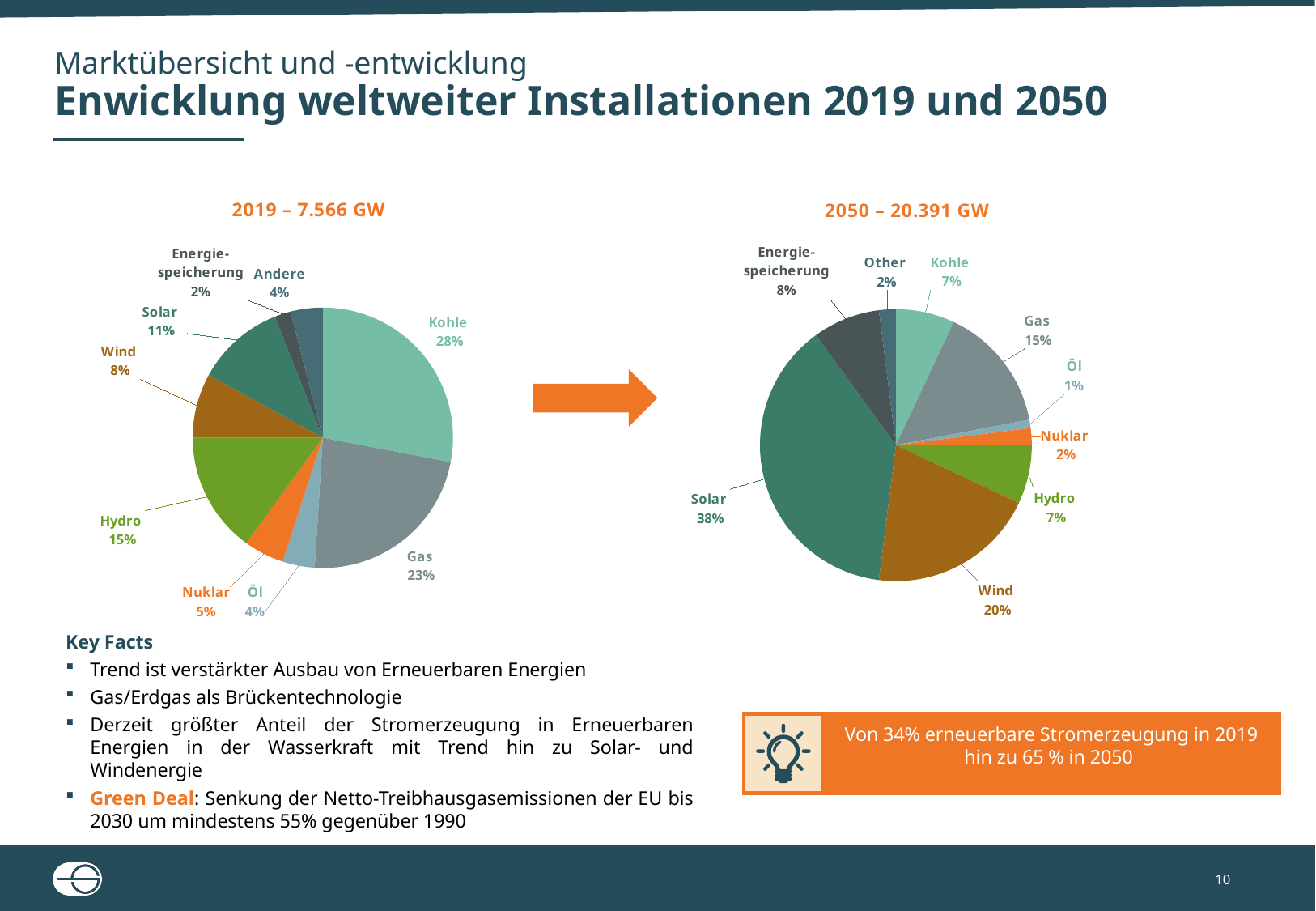
In the 2019 – 7.566 GW pie chart, what share does Kohle have? 28% What is the title of the pie chart on the left side of the slide? 2019 – 7.566 GW In the 2050 – 20.391 GW pie chart, which category has the smallest share? Öl In the 2050 – 20.391 GW pie chart, what is the difference between the shares of Solar and Kohle? 31% In the 2050 – 20.391 GW pie chart, what share does Solar have? 38% In the 2050 – 20.391 GW pie chart, which is larger, the share of Wind or the share of Gas? Wind In the 2050 – 20.391 GW pie chart, what share does Energiespeicherung have? 8% How many categories are shown in the 2019 – 7.566 GW pie chart? 9 In the 2019 – 7.566 GW pie chart, which category has the largest share? Kohle In the 2019 – 7.566 GW pie chart, what is the combined share of Solar and Wind? 19% What kind of chart is used for the 2050 – 20.391 GW data? Pie chart In the 2019 – 7.566 GW pie chart, what is the difference between the shares of Gas and Hydro? 8%